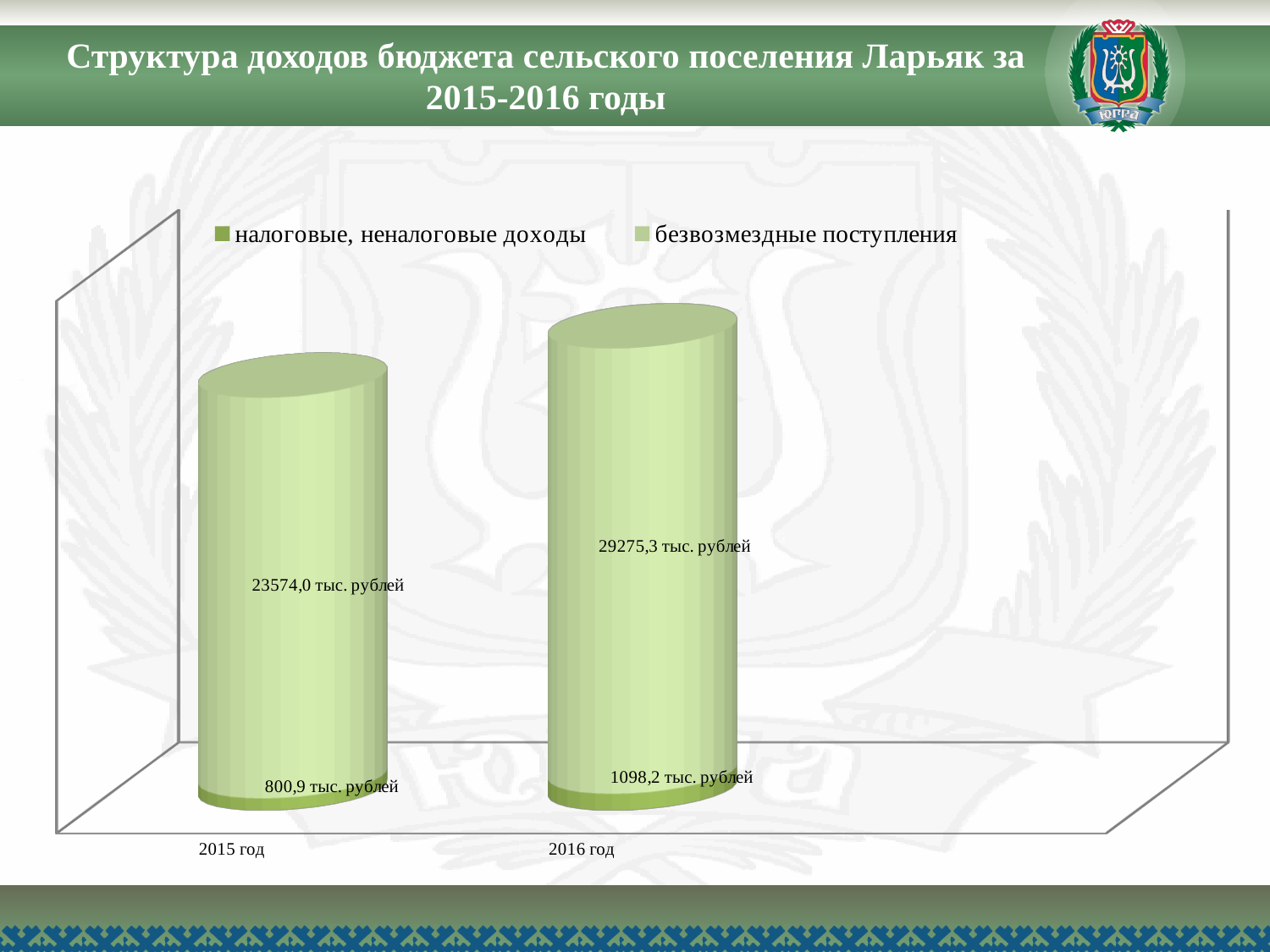
How many series does the legend list? 2 What is the difference between налоговые, неналоговые доходы in 2016 год and 2015 год? 297,3 тыс. рублей What is the total of the stacked bar for 2016 год? 30373,5 тыс. рублей What is the value of налоговые, неналоговые доходы for 2015 год? 800,9 тыс. рублей What is the value of налоговые, неналоговые доходы for 2016 год? 1098,2 тыс. рублей What kind of chart is shown on the slide? Stacked bar chart What is the total of the stacked bar for 2015 год? 24374,9 тыс. рублей Which year has the higher value of безвозмездные поступления? 2016 год Which year has the lower value of налоговые, неналоговые доходы? 2015 год What is the value of безвозмездные поступления for 2015 год? 23574,0 тыс. рублей What is the value of безвозмездные поступления for 2016 год? 29275,3 тыс. рублей By how much did безвозмездные поступления increase from 2015 год to 2016 год? 5701,3 тыс. рублей